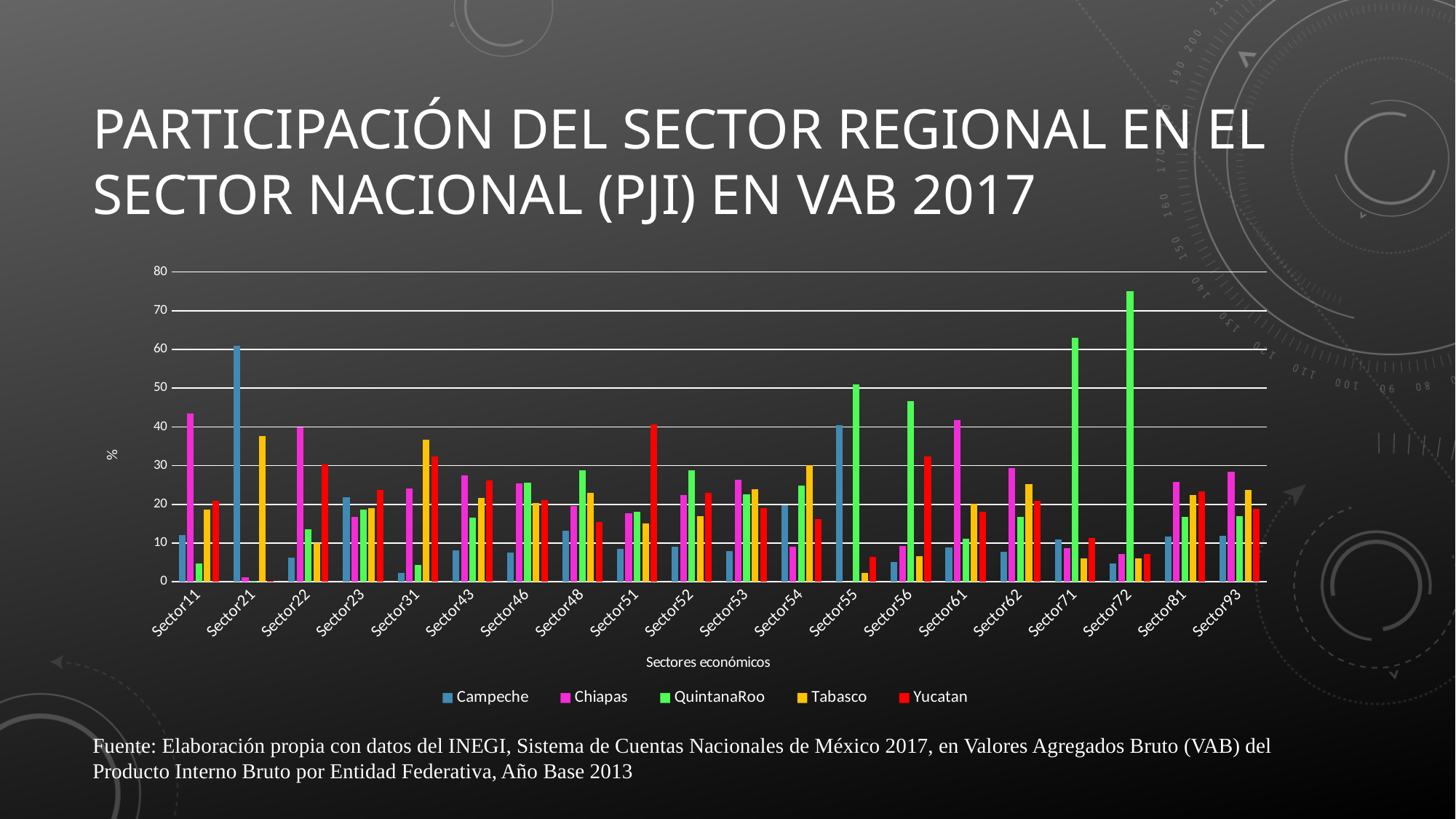
Is the value for QuintanaRoo in Sector72 greater or less than 70? greater In Sector55, which is larger: the value for Campeche or the value for QuintanaRoo? QuintanaRoo How many sector categories are shown on the x axis? 20 What kind of chart is shown on the slide? Bar chart In which sector does Yucatan have its highest value? Sector51 Is the value for Tabasco in Sector55 greater or less than 10? less How many series does the legend list? 5 In which sector does Campeche have its highest value? Sector21 Is the value for Campeche in Sector21 greater or less than 50? greater What is the title of the x axis? Sectores económicos In which sector does QuintanaRoo have its highest value? Sector72 In Sector21, which is larger: the value for Campeche or the value for Tabasco? Campeche